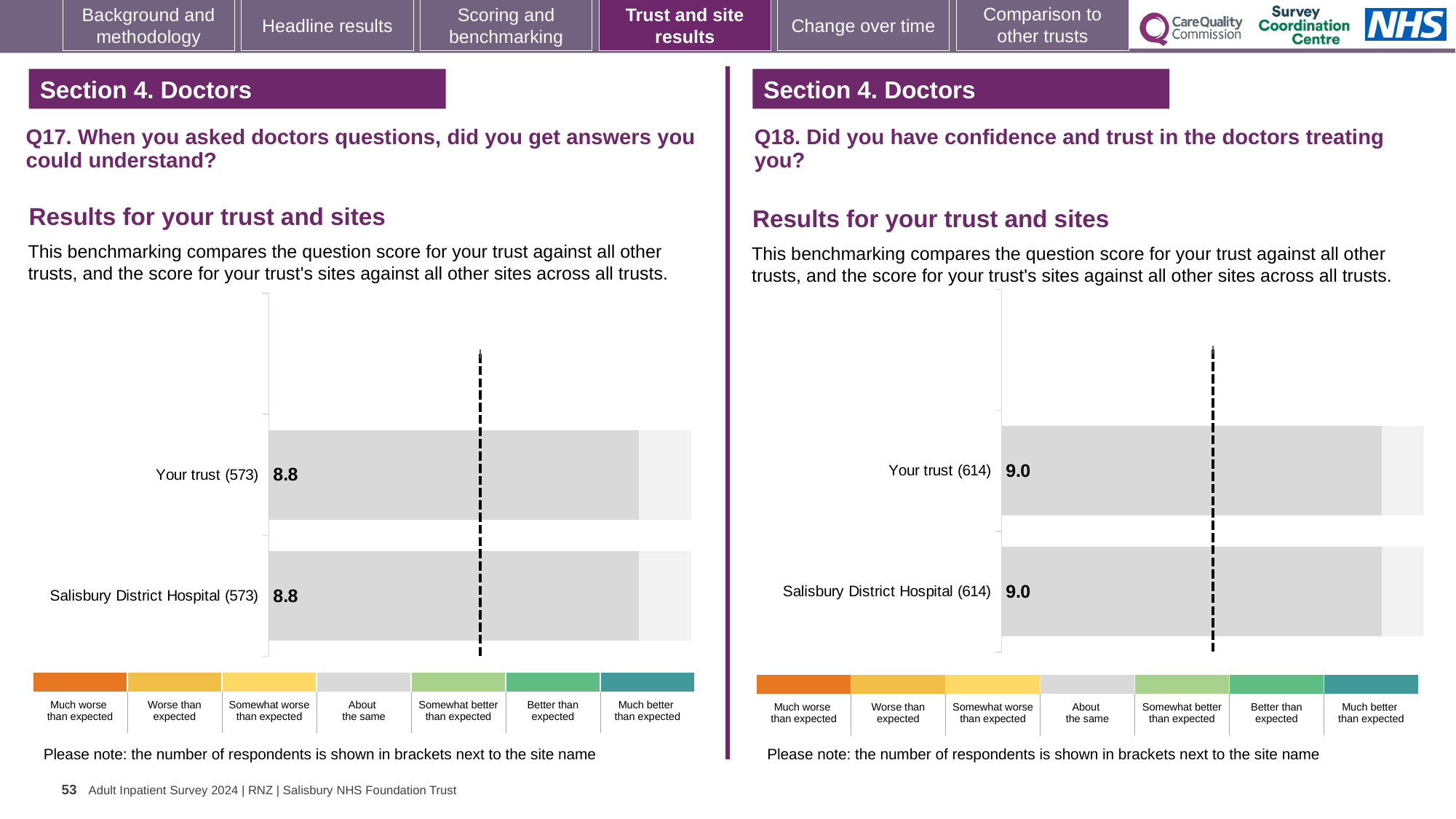
In the Q17 chart on the left, what is the score for Salisbury District Hospital (573)? 8.8 In the Q18 chart on the right, what is the score for Salisbury District Hospital (614)? 9.0 In the Q18 chart on the right, what is the difference between the score for Your trust and the score for Salisbury District Hospital? 0.0 In the Q17 chart on the left, how many respondents are shown in brackets for Your trust? 573 In the Q17 chart on the left, what is the difference between the score for Your trust and the score for Salisbury District Hospital? 0.0 Is the score for Your trust in the Q18 chart on the right larger than the score for Your trust in the Q17 chart on the left? Yes How many bars are plotted in the Q17 chart on the left? 2 What kind of chart is used for the Q17 results on the left? Bar chart In the Q18 chart on the right, what is the score for Your trust (614)? 9.0 How many bars are plotted in the Q18 chart on the right? 2 In the Q18 chart on the right, how many respondents are shown in brackets for Salisbury District Hospital? 614 In the Q17 chart on the left, what is the score for Your trust (573)? 8.8